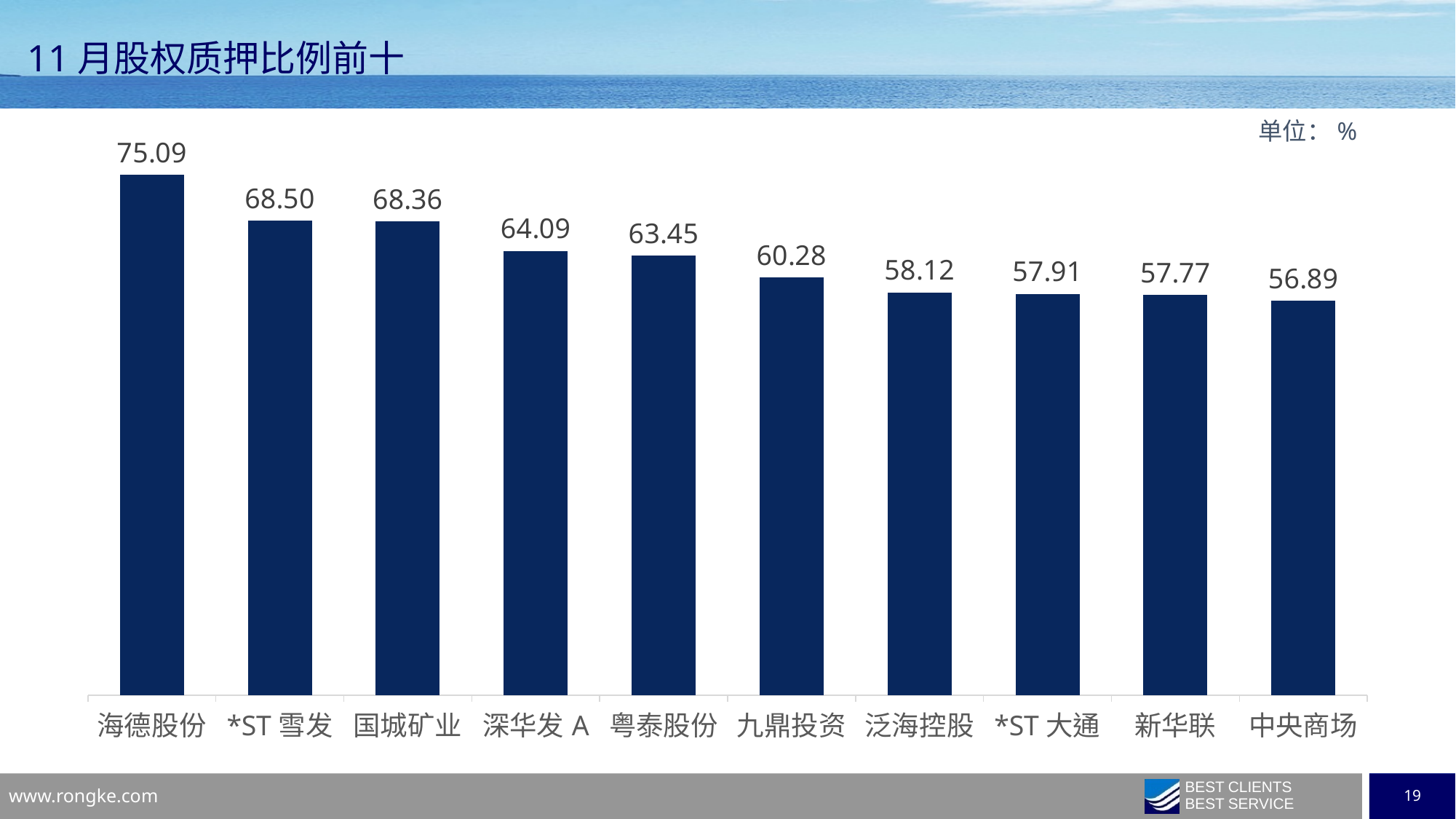
What kind of chart is shown on the slide? bar chart How many companies are shown in the chart? 10 Which is larger, the value for 深华发 A or the value for 泛海控股? 深华发 A Which company has the highest value? 海德股份 Which company has the lowest value? 中央商场 Do the values rise or fall from left to right across the chart? fall What is the value for 九鼎投资? 60.28 What is the difference between the values for 海德股份 and 中央商场? 18.20 What unit is indicated for the values in the chart? % What is the difference between the values for *ST 雪发 and 国城矿业? 0.14 What is the value for 海德股份? 75.09 What is the value for 中央商场? 56.89